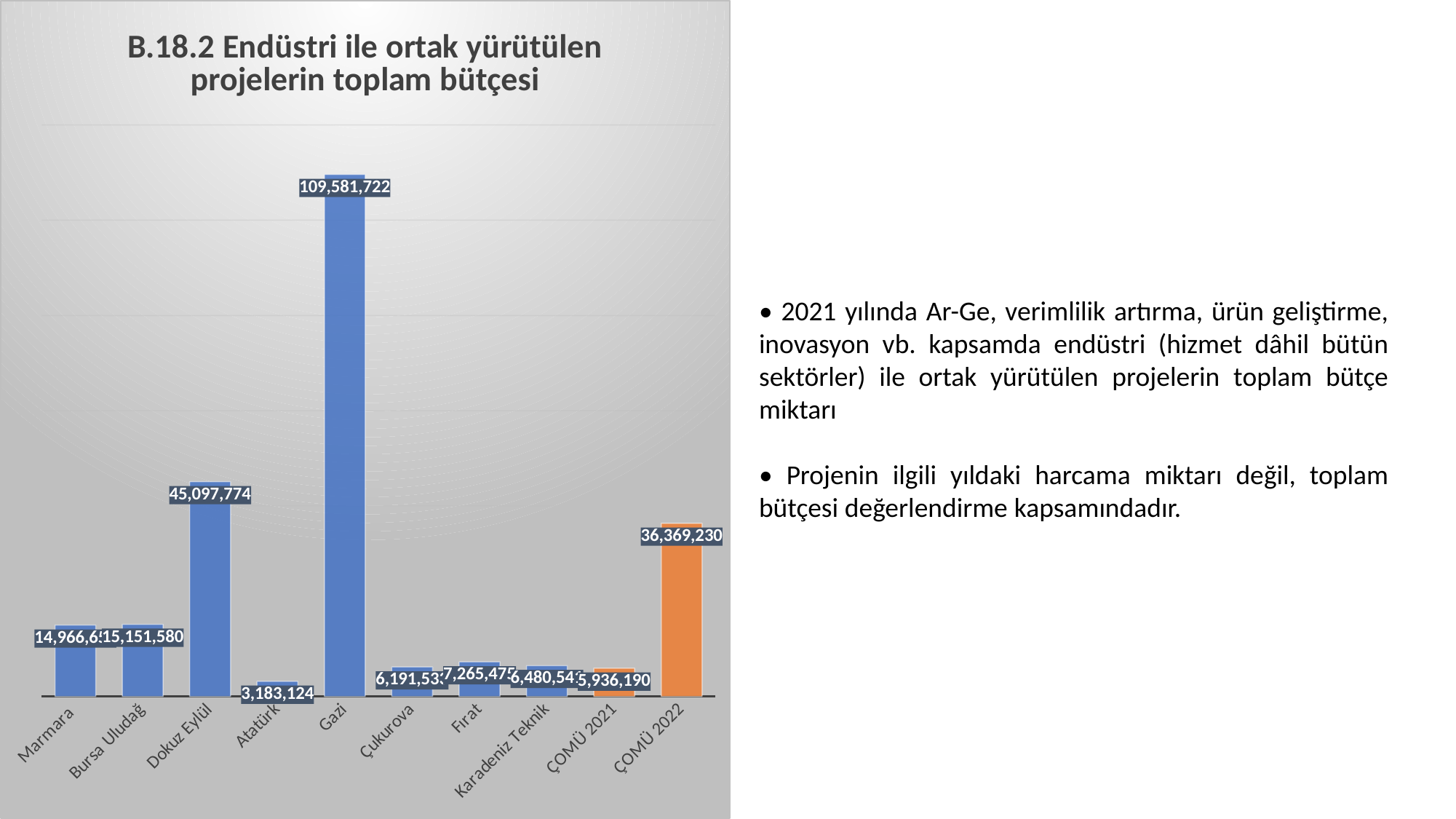
What is the value for Gazi? 109,581,722 Which category has the highest value? Gazi What is the value for ÇOMÜ 2022? 36,369,230 What is the value for Atatürk? 3,183,124 How many categories are shown on the x axis? 10 What kind of chart is shown on the slide? Bar chart What is the difference between the values for ÇOMÜ 2022 and ÇOMÜ 2021? 30,433,040 What is the difference between the values for Gazi and Dokuz Eylül? 64,483,948 Which category has the lowest value? Atatürk What is the value for Dokuz Eylül? 45,097,774 What is the value for ÇOMÜ 2021? 5,936,190 Which is larger, the value for Dokuz Eylül or the value for ÇOMÜ 2022? Dokuz Eylül